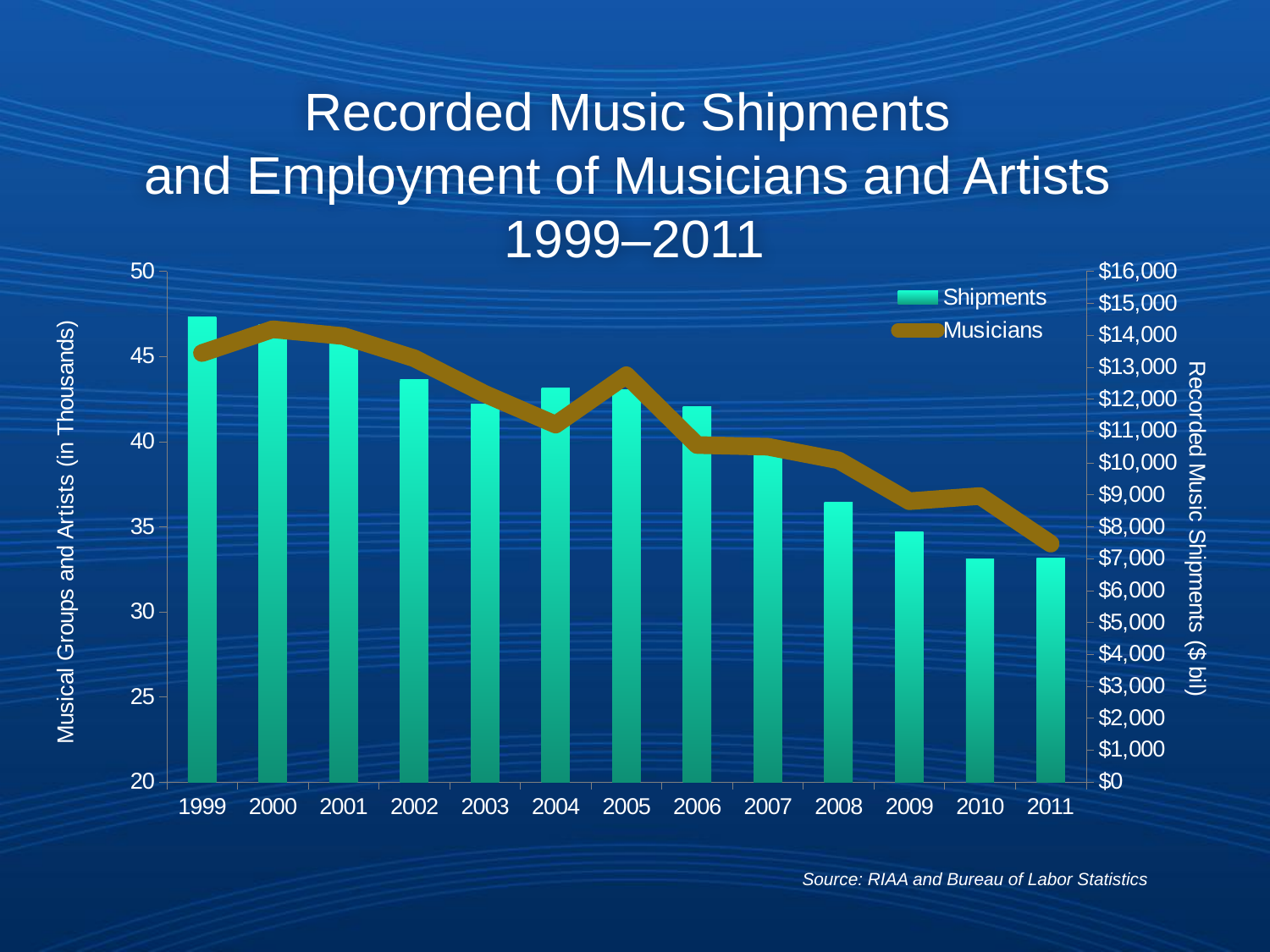
Which series is drawn as bars? Shipments Which year has the highest Shipments bar? 1999 What kind of chart is this? A combined bar and line chart How many series does the legend list? 2 In which year is the Musicians line at its lowest? 2011 Is the Shipments value for 1999 greater or less than $14,000? greater Is the Musicians value for 2011 greater or less than 35? less Is the Shipments value for 2011 greater or less than $8,000? less What is the label of the right-hand vertical axis? Recorded Music Shipments ($ bil) Which year has the larger Shipments value, 2007 or 2008? 2007 How many years are shown on the x axis? 13 Overall, do Shipments rise or fall from 1999 to 2011? fall